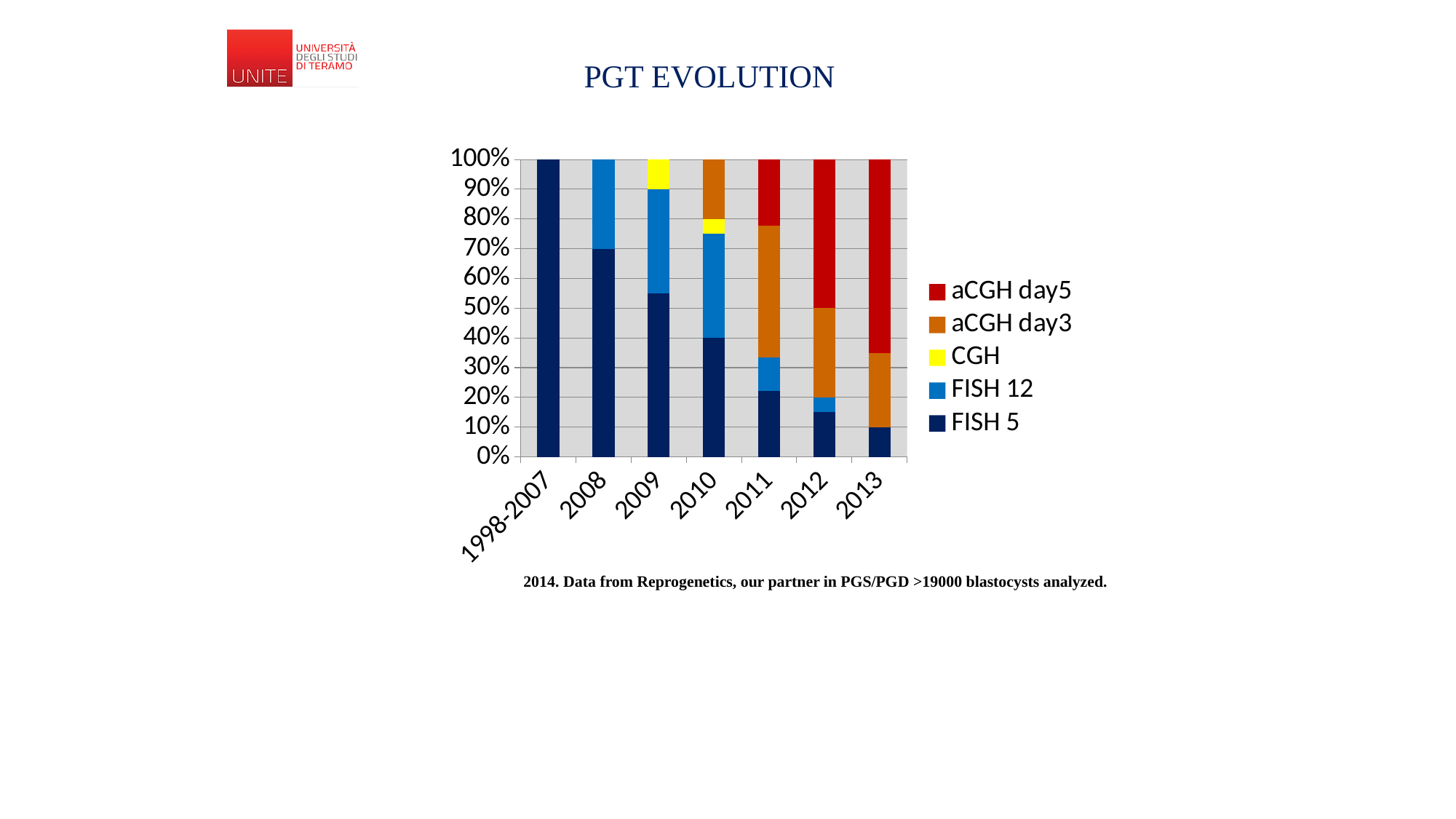
How many series does the legend list? 5 What is the FISH 5 share for 2010? 40% Which period has the lowest FISH 5 share? 2013 What kind of chart is shown on the slide? Stacked bar chart Is the aCGH day5 share for 2013 greater or less than 60%? greater How many time periods are shown along the x axis? 7 Is the FISH 5 share for 2012 greater or less than 20%? less What is the FISH 5 share for 2008? 70% What is the FISH 5 share for 1998-2007? 100% What is the aCGH day5 share for 2012? 50% Is the FISH 5 share for 2009 greater or less than 50%? greater Does the FISH 5 share rise or fall from 1998-2007 to 2013? Fall